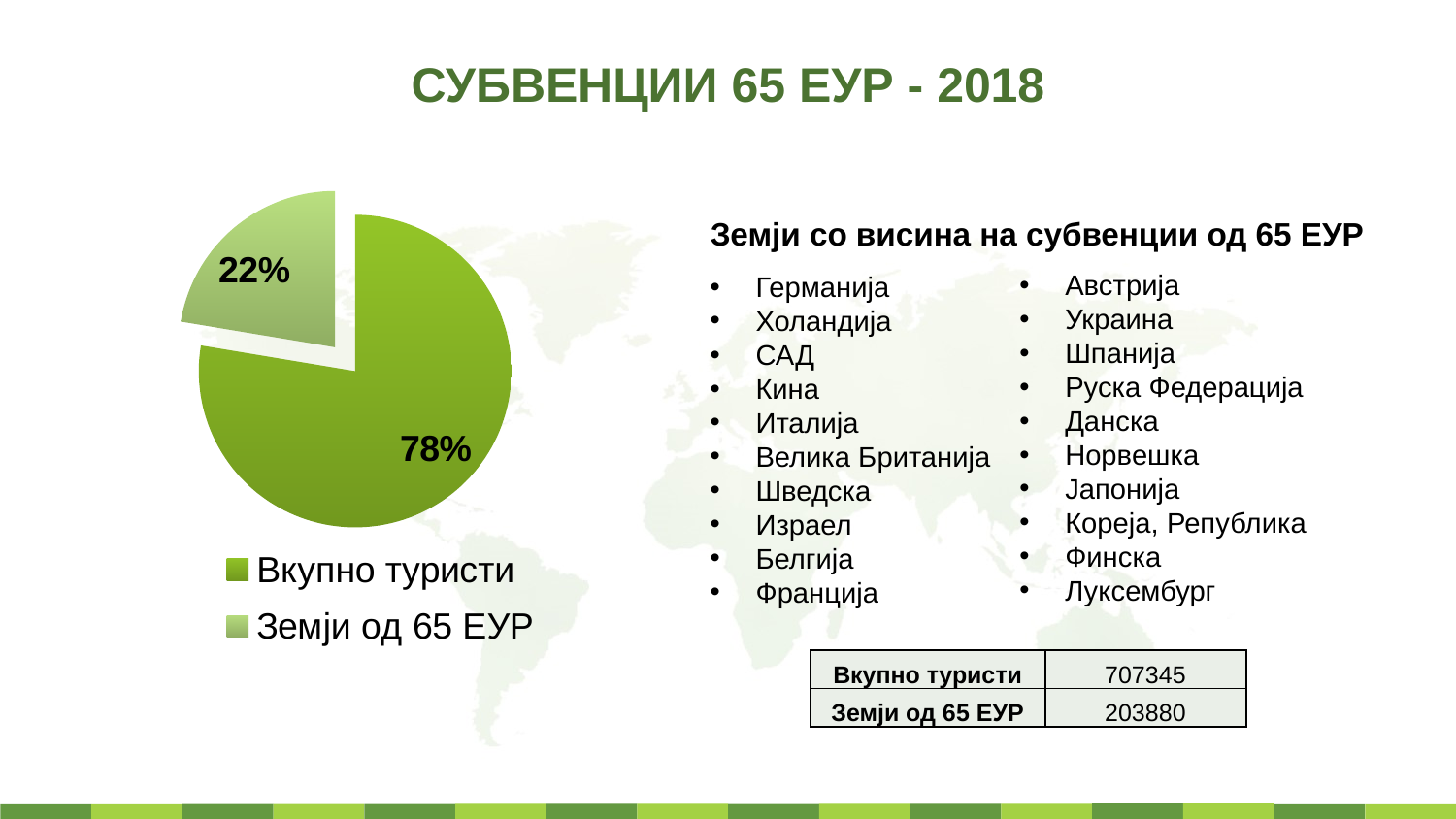
Which legend entry is shown in the lighter green colour? Земји од 65 ЕУР Is the share of the "Земји од 65 ЕУР" slice greater or less than 50%? less Which slice of the pie chart is the smallest? Земји од 65 ЕУР What kind of chart is shown on the slide? pie chart Which slice of the pie chart is the largest? Вкупно туристи Which slice is larger, "Вкупно туристи" or "Земји од 65 ЕУР"? Вкупно туристи What share of the pie does the slice "Вкупно туристи" represent? 78% How many entries does the legend of the pie chart list? 2 What is the difference in percentage points between the "Вкупно туристи" slice and the "Земји од 65 ЕУР" slice? 56 What is the title of the slide containing the pie chart? СУБВЕНЦИИ 65 ЕУР - 2018 How many slices does the pie chart have? 2 What share of the pie does the slice "Земји од 65 ЕУР" represent? 22%